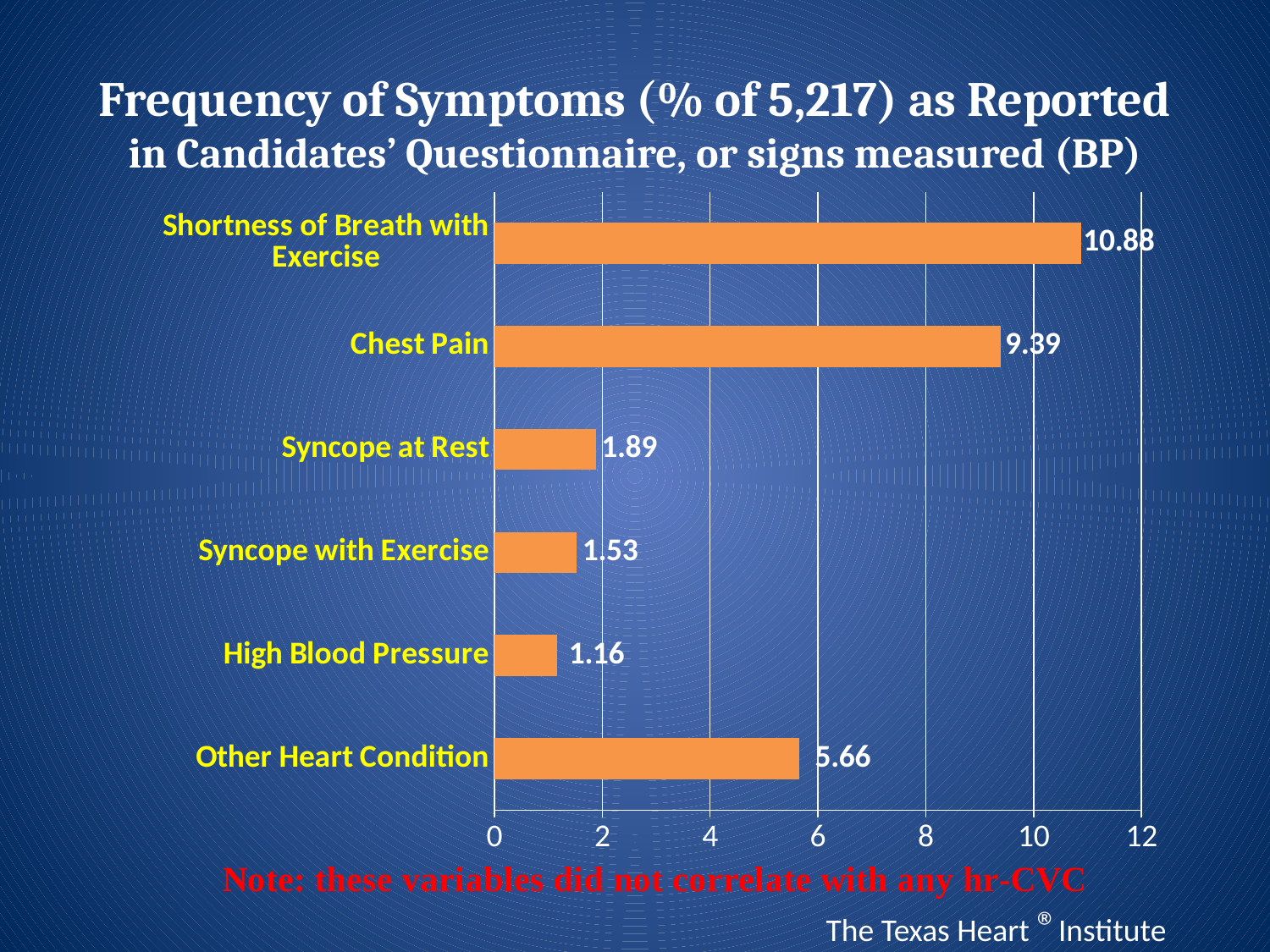
What is the maximum value shown on the horizontal axis? 12 Which category has the lowest value? High Blood Pressure What is the value for Shortness of Breath with Exercise? 10.88 Which category has the highest value? Shortness of Breath with Exercise What kind of chart is shown on the slide? Bar chart What is the value for Chest Pain? 9.39 What is the value for Syncope at Rest? 1.89 What is the value for Other Heart Condition? 5.66 How many categories are shown in the chart? 6 What is the value for High Blood Pressure? 1.16 Which is larger, the value for Syncope at Rest or the value for Syncope with Exercise? Syncope at Rest What is the difference between the values for Shortness of Breath with Exercise and Chest Pain? 1.49